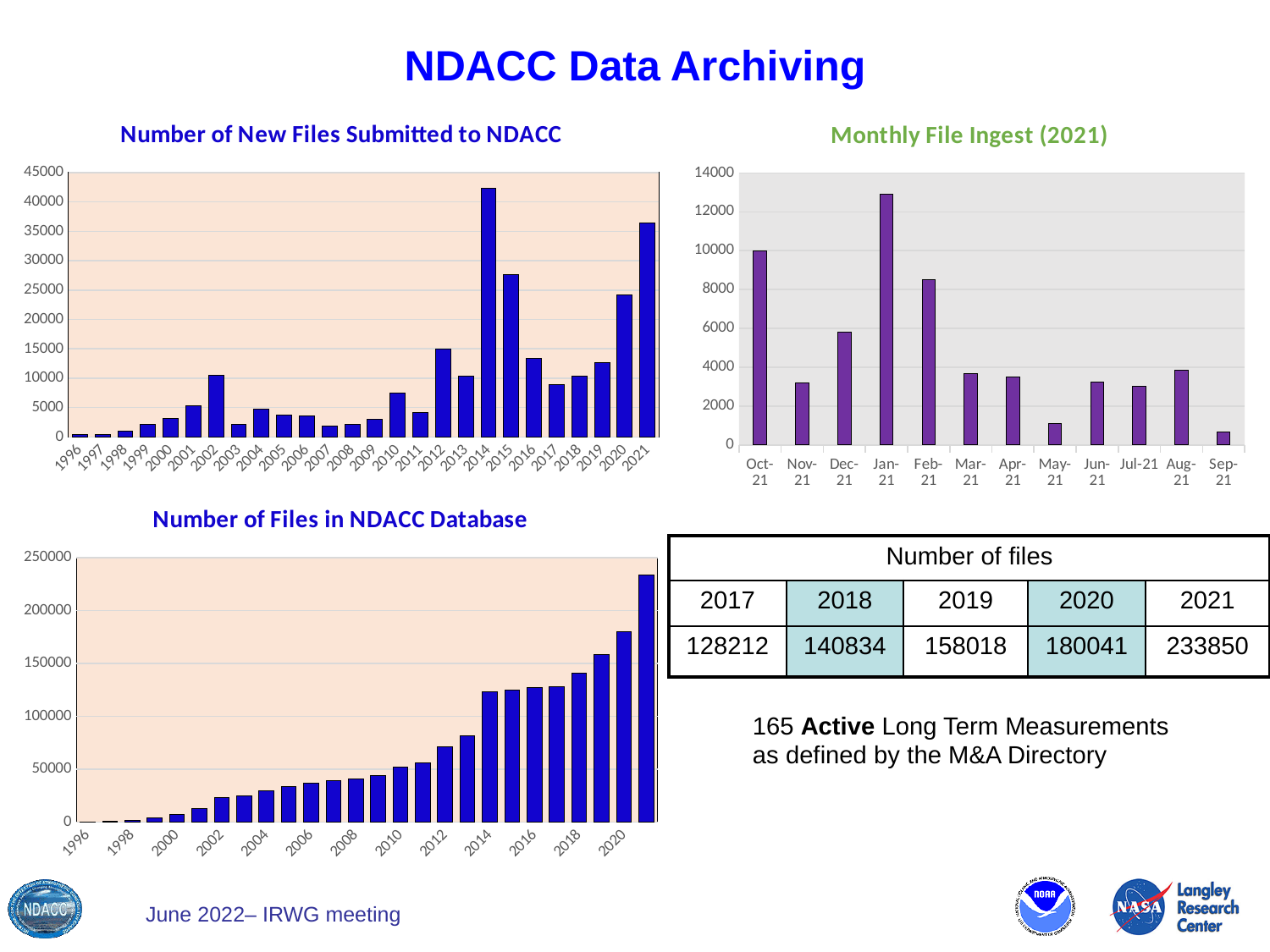
In the 'Number of New Files Submitted to NDACC' chart, is the value for 2021 greater or less than 35000? greater In the 'Monthly File Ingest (2021)' chart, which month has the lowest value? Sep-21 In the 'Number of Files in NDACC Database' chart, is the value for 2021 greater or less than 200000? greater How many months are shown in the 'Monthly File Ingest (2021)' chart? 12 In the 'Monthly File Ingest (2021)' chart, which month has the highest value? Jan-21 In the 'Number of New Files Submitted to NDACC' chart, is the value for 2014 greater or less than 40000? greater In the 'Number of Files in NDACC Database' chart, do the values generally rise or fall from 1996 to 2021? rise What kind of chart is the 'Number of Files in NDACC Database' chart? bar chart In the 'Number of New Files Submitted to NDACC' chart, which year has the highest value? 2014 In the 'Number of New Files Submitted to NDACC' chart, which is larger, the value for 2014 or the value for 2015? 2014